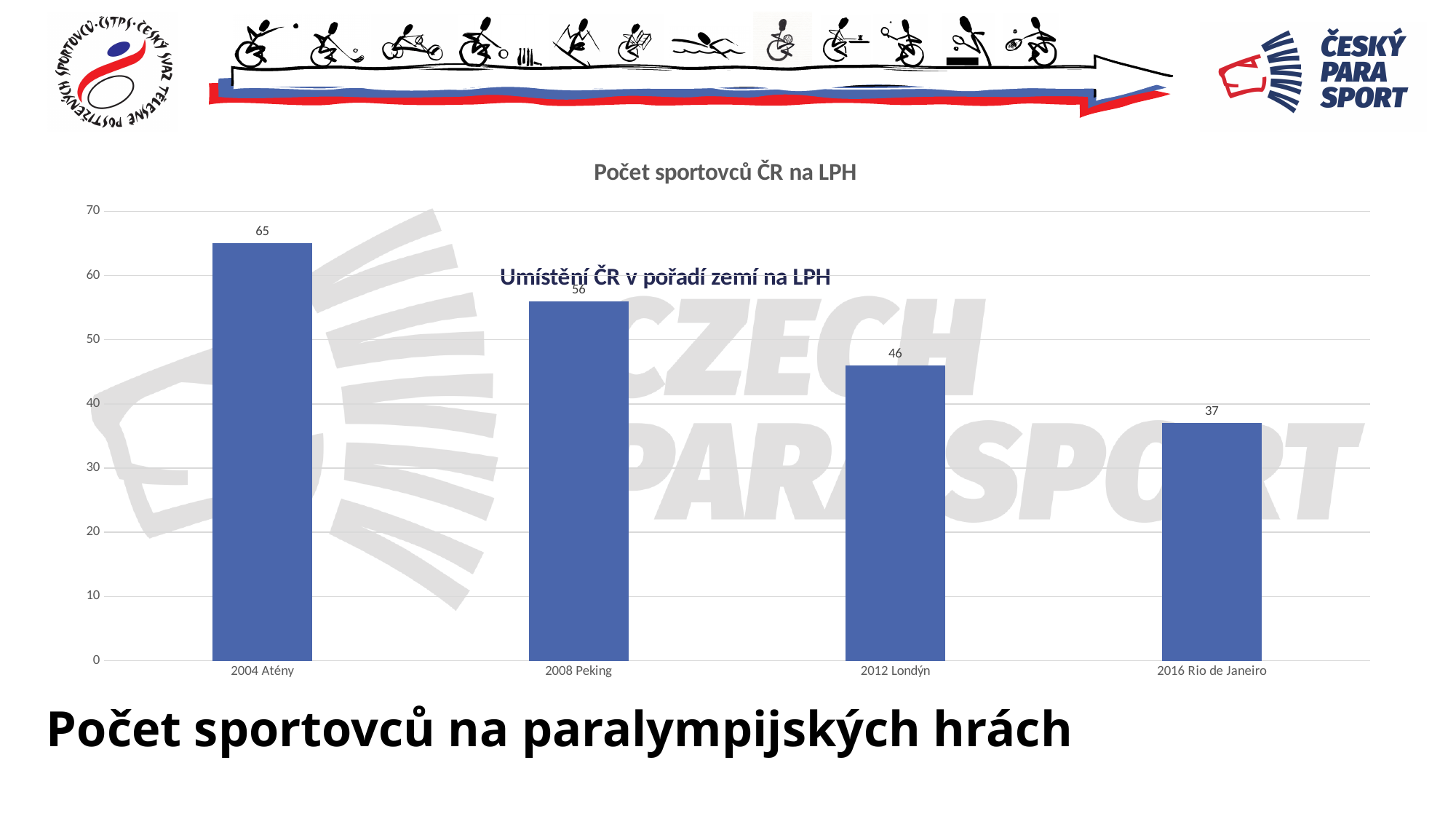
Which is larger in the chart "Počet sportovců ČR na LPH": the value for 2008 Peking or the value for 2012 Londýn? 2008 Peking What is the value for 2012 Londýn in the chart "Počet sportovců ČR na LPH"? 46 Which category has the lowest value in the chart "Počet sportovců ČR na LPH"? 2016 Rio de Janeiro What kind of chart is "Počet sportovců ČR na LPH"? bar chart Which category has the highest value in the chart "Počet sportovců ČR na LPH"? 2004 Atény Is the value for 2012 Londýn greater or less than 50 in the chart "Počet sportovců ČR na LPH"? less Do the values in the chart "Počet sportovců ČR na LPH" rise or fall from 2004 Atény to 2016 Rio de Janeiro? fall How many categories are shown in the chart "Počet sportovců ČR na LPH"? 4 What is the value for 2016 Rio de Janeiro in the chart "Počet sportovců ČR na LPH"? 37 What is the value for 2008 Peking in the chart "Počet sportovců ČR na LPH"? 56 What is the value for 2004 Atény in the chart "Počet sportovců ČR na LPH"? 65 What is the difference between the values for 2004 Atény and 2016 Rio de Janeiro in the chart "Počet sportovců ČR na LPH"? 28